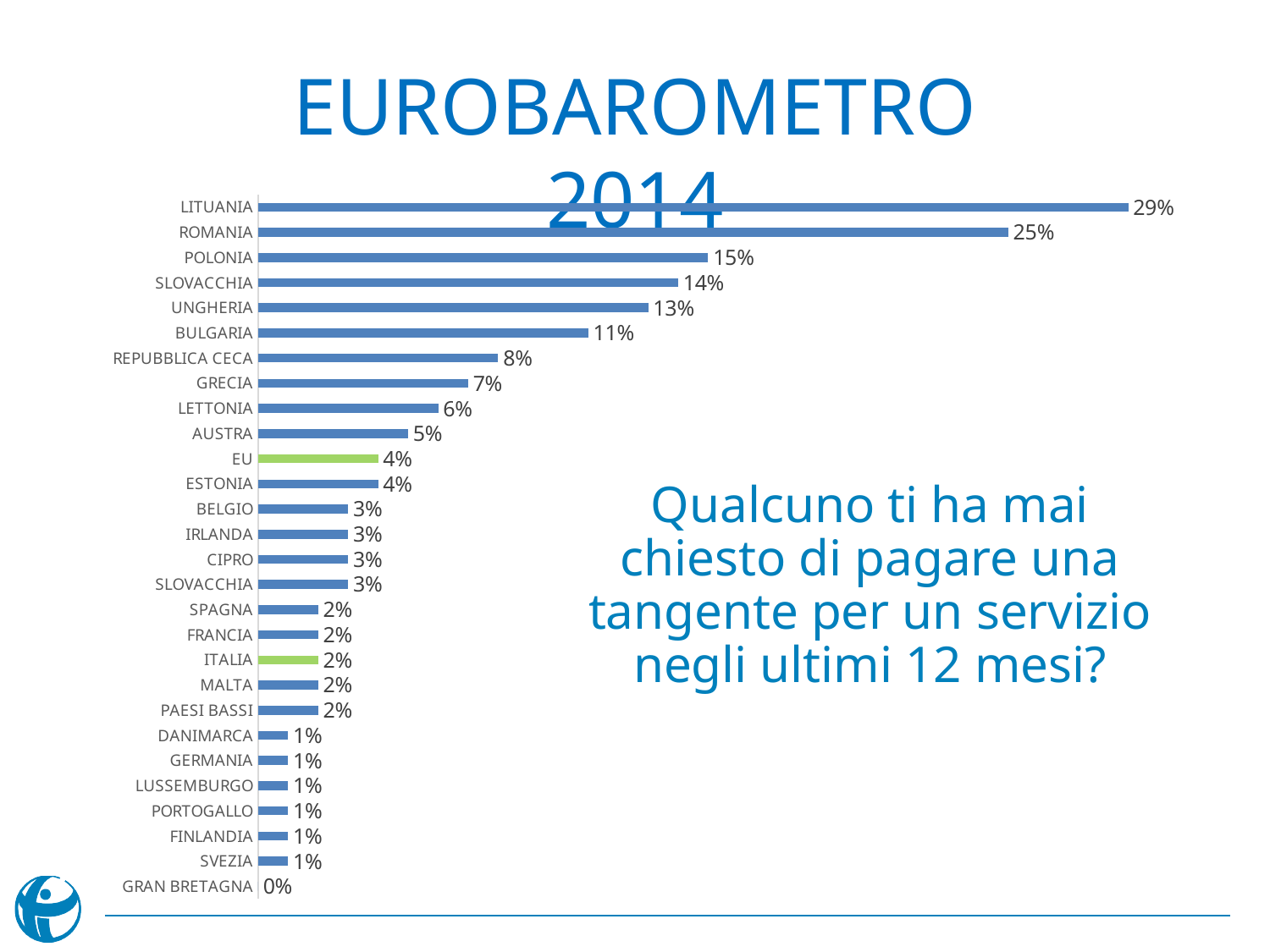
What is the difference between the values for EU and ITALIA? 2% What is the value for EU? 4% Which category has the highest value? LITUANIA Which has a larger value, POLONIA or BULGARIA? POLONIA How many categories are plotted in the chart? 28 What is the value for UNGHERIA? 13% What is the value for ITALIA? 2% What type of chart is shown on the slide? bar chart What is the value for LITUANIA? 29% Which two categories are shown with green bars instead of blue? EU and ITALIA Which category has the lowest value? GRAN BRETAGNA What is the difference between the values for LITUANIA and ROMANIA? 4%